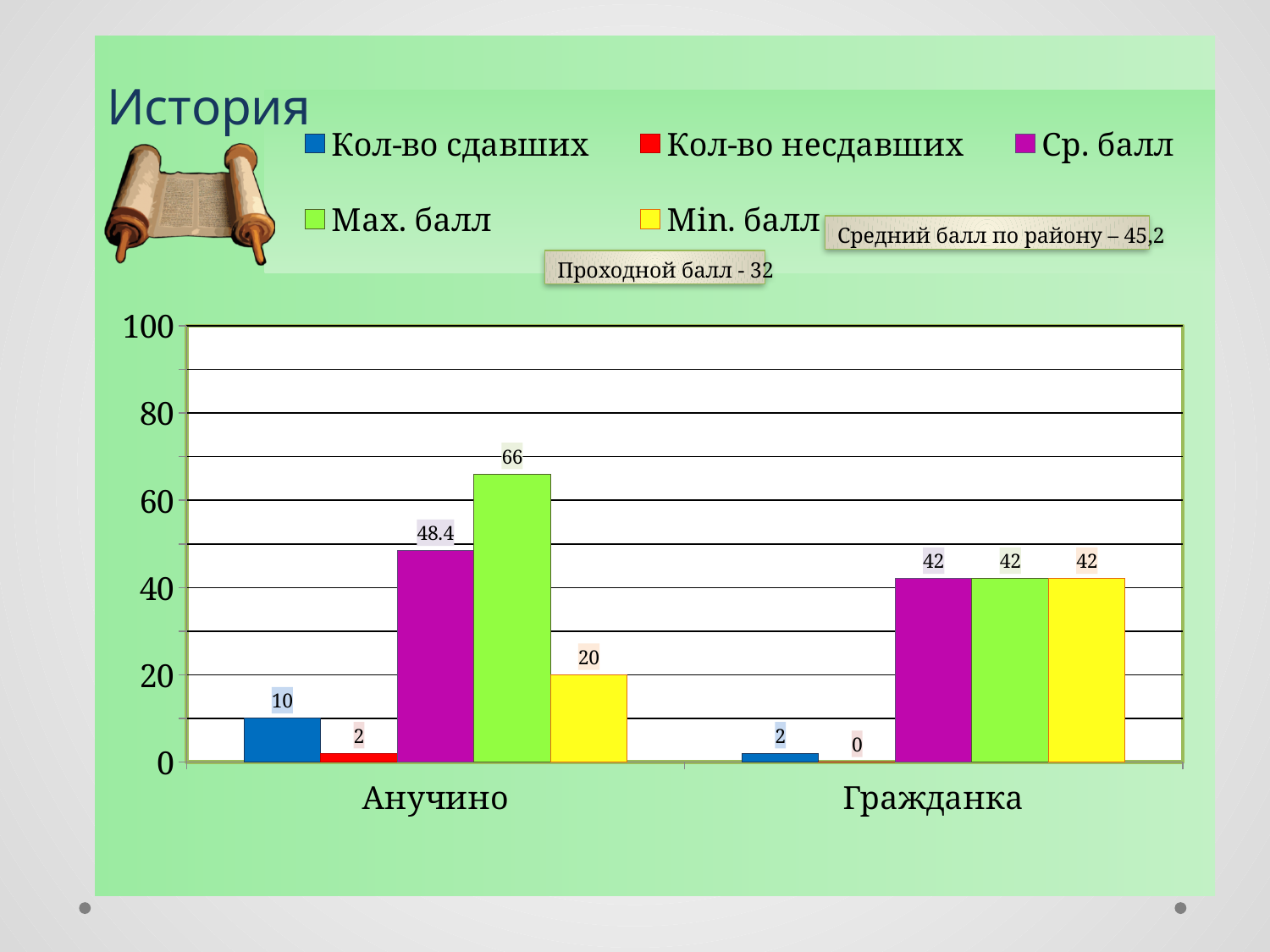
What is the difference between Max. балл and Min. балл for Анучино? 46 What is the difference in Кол-во сдавших between Анучино and Гражданка? 8 What is the value of Min. балл for Анучино? 20 What kind of chart is shown on the slide? bar chart How many series does the legend list? 5 Which colour represents Ср. балл in the legend? magenta (purple) What is the value of Ср. балл for Гражданка? 42 What is the value of Кол-во сдавших for Анучино? 10 What is the value of Кол-во несдавших for Гражданка? 0 Which category has the higher Max. балл, Анучино or Гражданка? Анучино What is the value of Max. балл for Анучино? 66 How many categories are shown on the x axis? 2